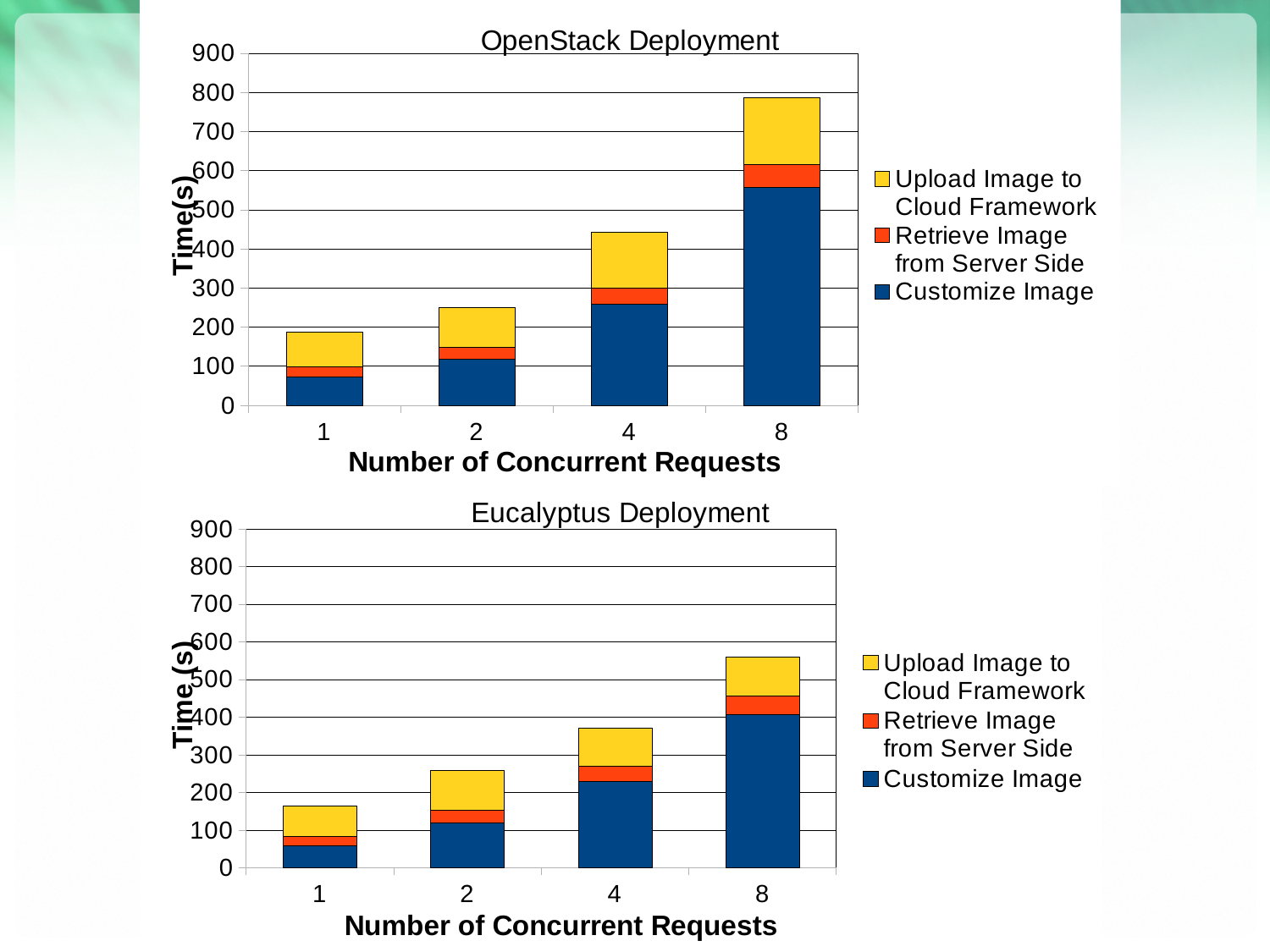
In the Eucalyptus Deployment chart, which is larger: the total time for 4 concurrent requests or for 2 concurrent requests? 4 concurrent requests In the Eucalyptus Deployment chart, is the total time for 1 concurrent request greater or less than 200? less In the Eucalyptus Deployment chart, how many categories are shown on the x axis? 4 In the OpenStack Deployment chart, what is the label of the y axis? Time(s) In the OpenStack Deployment chart, what kind of chart is shown? stacked bar chart In the Eucalyptus Deployment chart, does the total time rise or fall as the number of concurrent requests increases? rise In the OpenStack Deployment chart, how many series does the legend list? 3 In the Eucalyptus Deployment chart, which number of concurrent requests has the shortest stacked bar? 1 In the OpenStack Deployment chart, is the total time for 4 concurrent requests greater or less than 500? less In the OpenStack Deployment chart, which number of concurrent requests has the tallest stacked bar? 8 In the Eucalyptus Deployment chart, is the total time for 8 concurrent requests greater or less than 500? greater